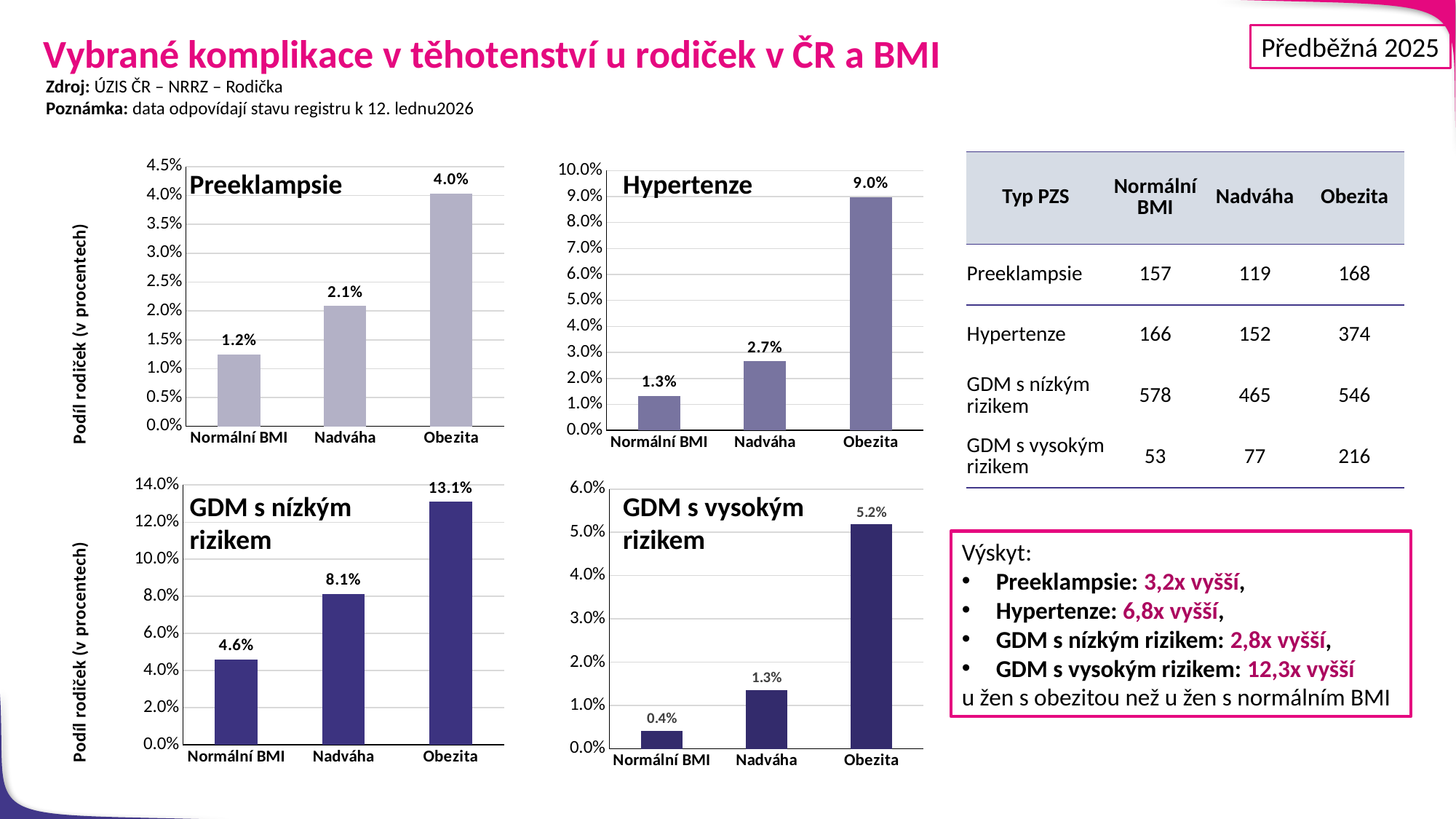
How many categories are shown on the x axis of the Preeklampsie chart? 3 In the Preeklampsie chart, what is the difference between the values for Nadváha and Normální BMI? 0.9% What kind of chart is the GDM s nízkým rizikem chart? Bar chart In the GDM s nízkým rizikem chart, what is the difference between the values for Obezita and Nadváha? 5.0% In the GDM s vysokým rizikem chart, which category has the lowest value? Normální BMI In the Hypertenze chart, which category has the highest value? Obezita In the Hypertenze chart, what is the value for Nadváha? 2.7% In the GDM s vysokým rizikem chart, what is the value for Obezita? 5.2% In the Hypertenze chart, which is larger: the value for Normální BMI or the value for Nadváha? Nadváha In the GDM s vysokým rizikem chart, do the values rise or fall from Normální BMI to Obezita? Rise In the GDM s nízkým rizikem chart, what is the value for Normální BMI? 4.6% In the Preeklampsie chart, what is the value for Obezita? 4.0%